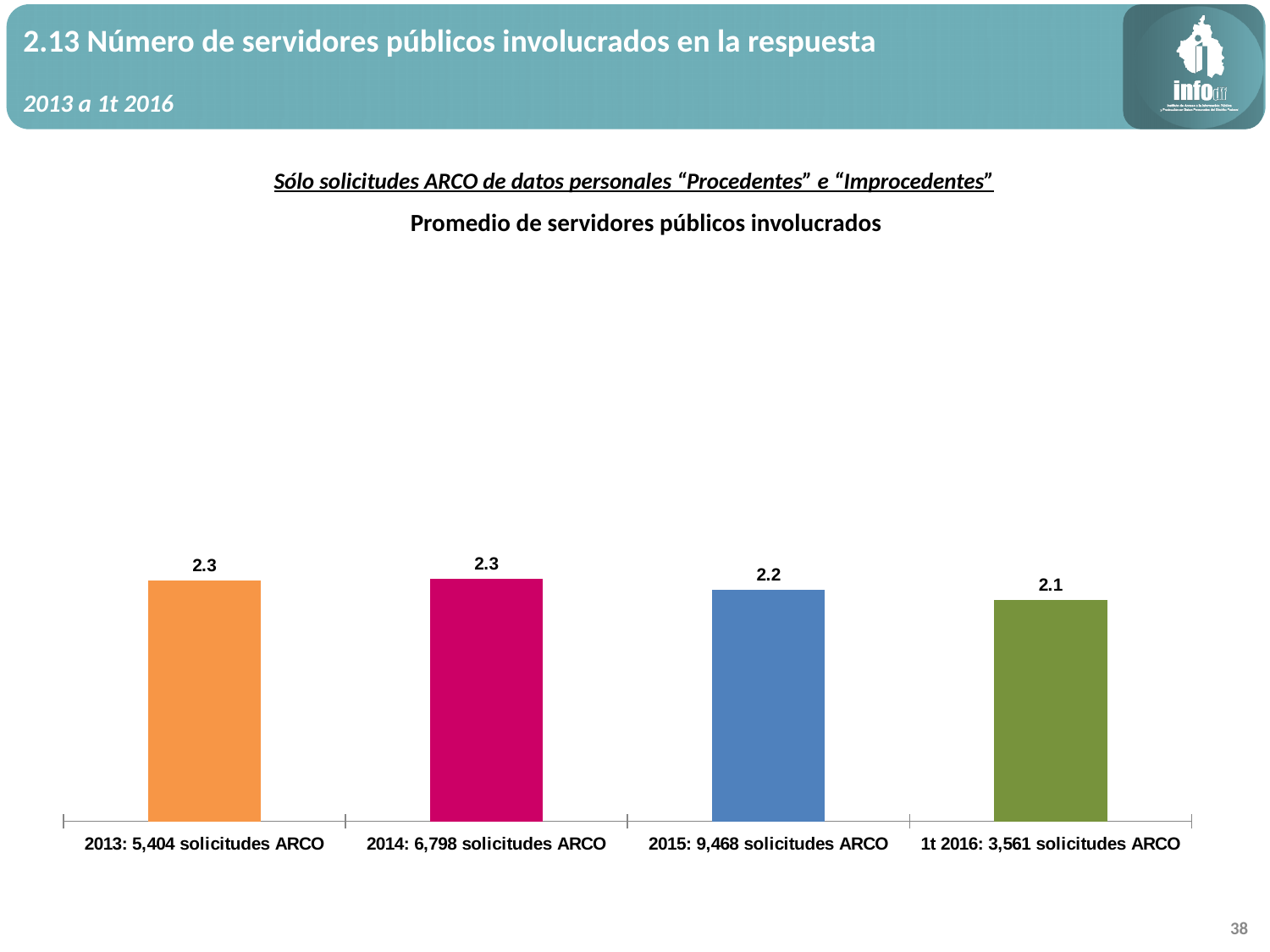
Do the values rise or fall from 2013 to 1t 2016? Fall What is the average number of public servants involved for 2013? 2.3 What is the value shown for 2015? 2.2 How many bars are shown in the chart? 4 Which category has the lowest value? 1t 2016 What colour is the bar for 2014? Magenta Which is larger, the value for 2015 or the value for 1t 2016? 2015 What is the difference between the values for 2014 and 1t 2016? 0.2 What is the value shown for 1t 2016? 2.1 What kind of chart is shown on the slide? Bar chart How many ARCO requests are stated in the label for 2015? 9,468